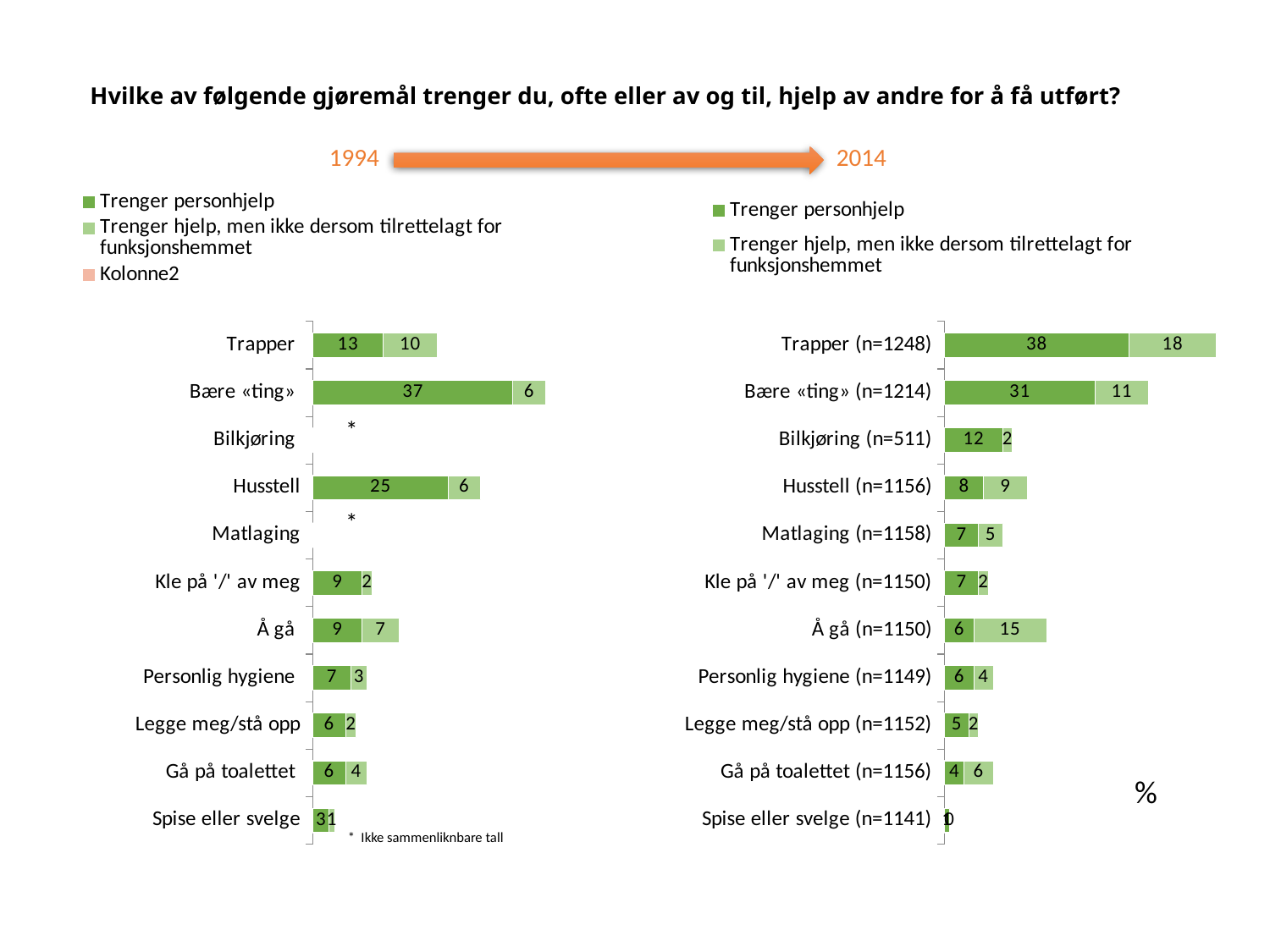
In the 1994 chart, what is the value of "Trenger personhjelp" for Bære «ting»? 37 How many categories are listed on the 2014 chart? 11 What kind of chart is the 2014 chart? Stacked bar chart How many series does the legend of the 1994 chart list? 3 In the 2014 chart, what is the total of the stacked bar for Trapper (n=1248)? 56 In the 1994 chart, what is the total of the stacked bar for Husstell? 31 In the 1994 chart, which categories are marked with an asterisk instead of a bar? Bilkjøring and Matlaging In the 2014 chart, which category has the highest "Trenger personhjelp" value? Trapper (n=1248) In the 2014 chart, what is the difference between the "Trenger personhjelp" values for Trapper (n=1248) and Bære «ting» (n=1214)? 7 In the 2014 chart, what is the value of "Trenger hjelp, men ikke dersom tilrettelagt for funksjonshemmet" for Å gå (n=1150)? 15 In the 1994 chart, which is larger: the "Trenger personhjelp" value for Trapper or for Husstell? Husstell In the 2014 chart, what is the "Trenger personhjelp" value for Bilkjøring (n=511)? 12